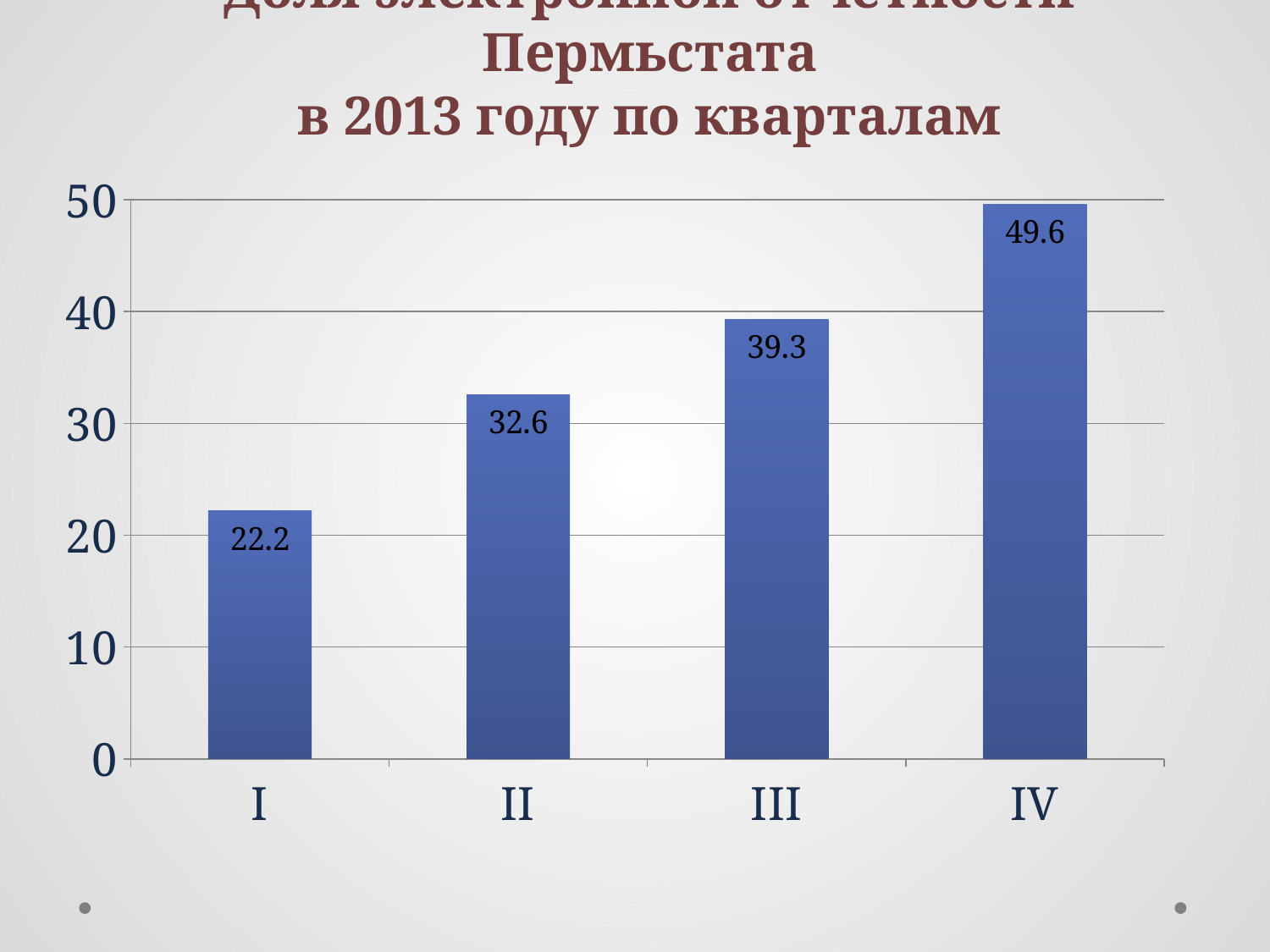
What is the difference between the values for quarter III and quarter II? 6.7 Do the values rise or fall from quarter I to quarter IV? rise What kind of chart is shown on the slide? bar chart What is the value for quarter IV? 49.6 Which quarter has the lowest value? I Which is larger, the value for quarter II or quarter III? III Which quarter has the highest value? IV What is the value for quarter I? 22.2 What is the difference between the values for quarter IV and quarter I? 27.4 What is the value for quarter III? 39.3 How many quarters are shown on the chart? 4 What is the value for quarter II? 32.6